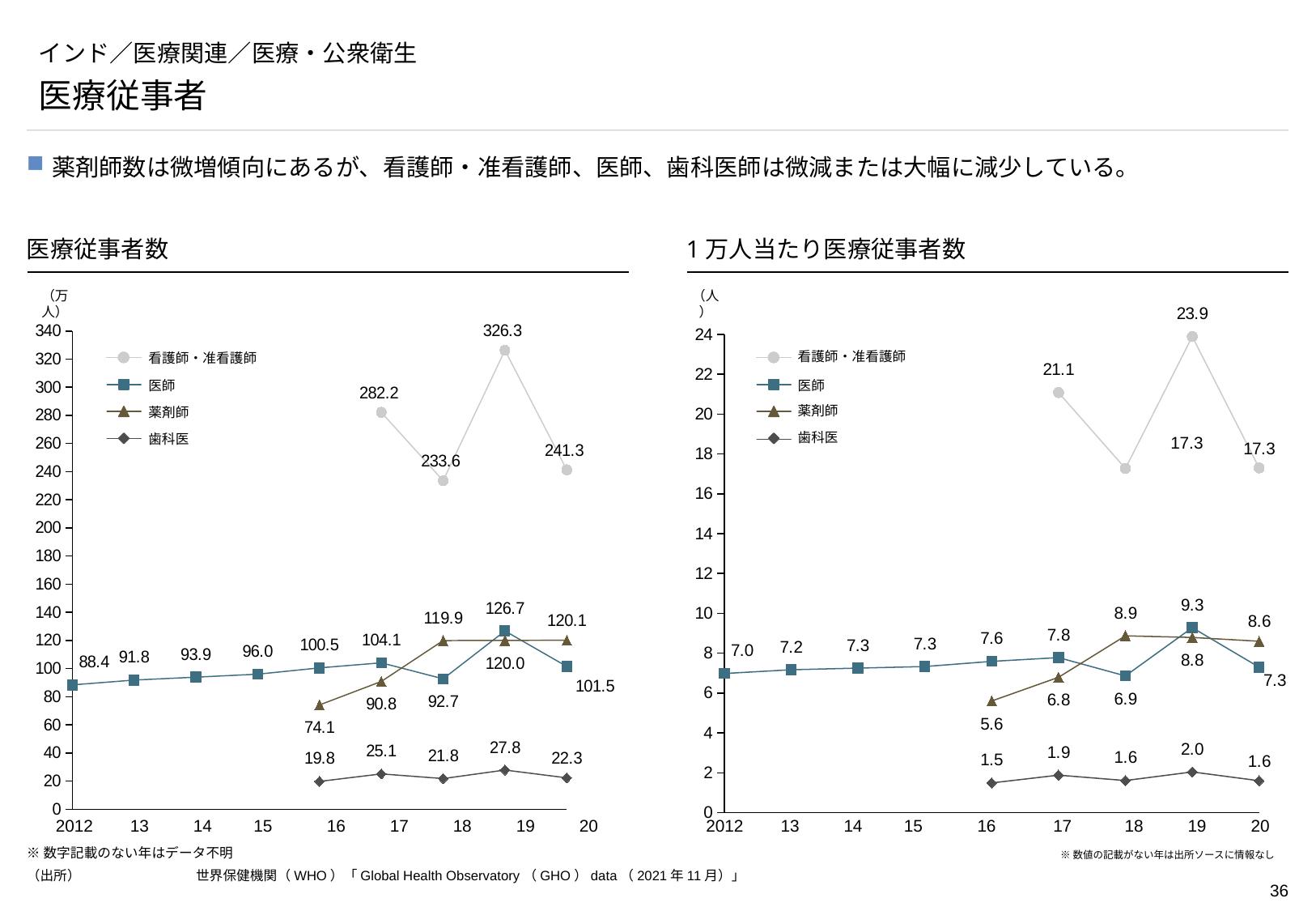
How many series does the legend of the left chart (医療従事者数) list? 4 What kind of chart is the right chart (1万人当たり医療従事者数)? Line chart In the left chart (医療従事者数), what is the value for 医師 in 2012? 88.4 In the left chart (医療従事者数), what is the value for 看護師・准看護師 in 2019? 326.3 In the left chart (医療従事者数), in which year is the 歯科医 value highest? 2019 In the left chart (医療従事者数), what is the difference between the 医師 values in 2019 and 2018? 34.0 In the right chart (1万人当たり医療従事者数), what is the difference between the 看護師・准看護師 values in 2019 and 2020? 6.6 In the left chart (医療従事者数), which is larger in 2020: 薬剤師 or 医師? 薬剤師 In the right chart (1万人当たり医療従事者数), does the 医師 value rise or fall from 2012 to 2017? Rise In the right chart (1万人当たり医療従事者数), what is the value for 薬剤師 in 2018? 8.9 In the right chart (1万人当たり医療従事者数), in which year is the 看護師・准看護師 value highest? 2019 In the right chart (1万人当たり医療従事者数), what is the lowest value shown for 歯科医? 1.5